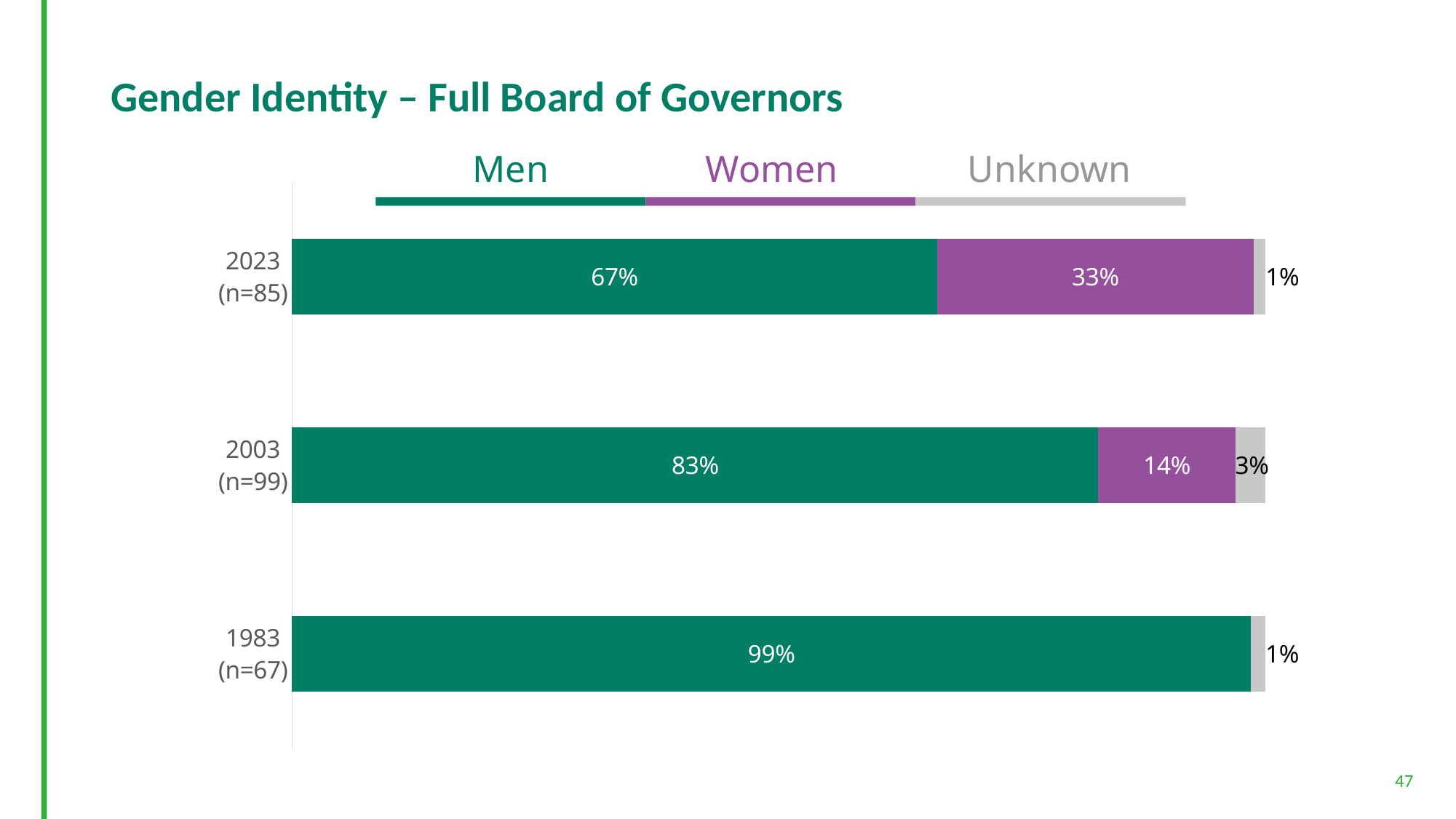
What percentage of the Full Board of Governors had unknown gender identity in 2003? 3% What percentage of the Full Board of Governors were men in 2023? 67% How many years (categories) are shown in the chart? 3 What percentage of the Full Board of Governors were men in 1983? 99% What kind of chart is shown on the slide? Stacked bar chart How many series does the legend list? 3 What is the sample size (n) for the 2003 bar? 99 Which is larger: the share of women in 2023 or the share of women in 2003? 2023 In which year was the share of men on the Full Board of Governors lowest? 2023 What percentage of the Full Board of Governors were women in 2003? 14% In which year was the share of women on the Full Board of Governors highest? 2023 What is the difference in percentage points between the share of men in 2003 and in 2023? 16